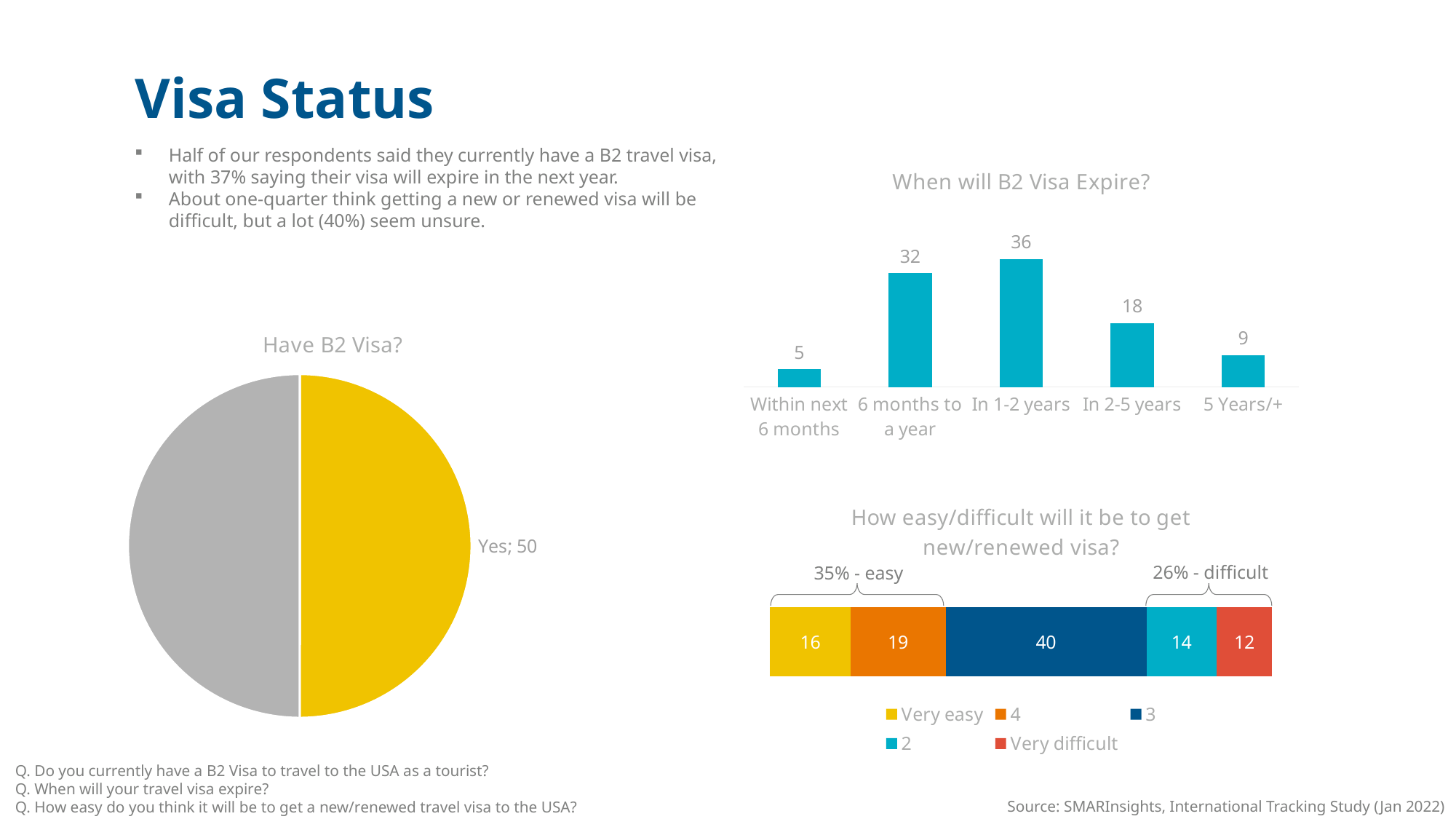
What kind of chart is 'Have B2 Visa?'? Pie chart In the 'How easy/difficult will it be to get new/renewed visa?' chart, what is the value for '3'? 40 In the 'When will B2 Visa Expire?' chart, how many categories are shown? 5 In the 'How easy/difficult will it be to get new/renewed visa?' chart, how many series does the legend list? 5 In the 'Have B2 Visa?' chart, what is the value for the 'Yes' slice? 50 In the 'How easy/difficult will it be to get new/renewed visa?' chart, which is larger: 'Very easy' or 'Very difficult'? Very easy In the 'How easy/difficult will it be to get new/renewed visa?' chart, what is the total of the stacked bar? 101 What kind of chart is 'When will B2 Visa Expire?'? Bar chart In the 'When will B2 Visa Expire?' chart, which category has the highest value? In 1-2 years In the 'When will B2 Visa Expire?' chart, what is the difference between '6 months to a year' and 'In 2-5 years'? 14 In the 'When will B2 Visa Expire?' chart, which category has the lowest value? Within next 6 months In the 'When will B2 Visa Expire?' chart, what is the value for 'In 1-2 years'? 36